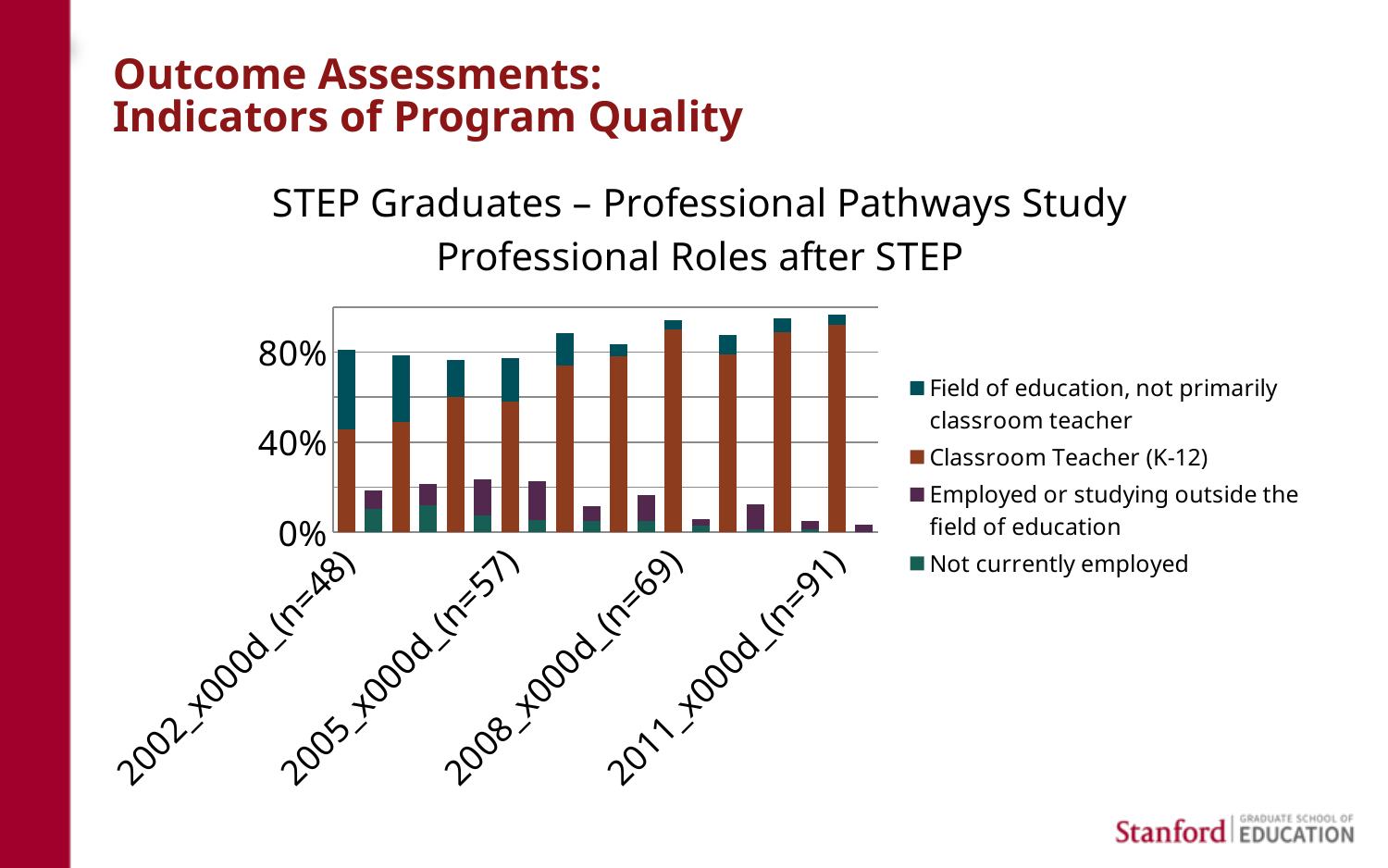
Which legend entry is shown in brown? Classroom Teacher (K-12) Is the Not currently employed value for 2011 (n=91) greater or less than 40%? less Is the Classroom Teacher (K-12) value for 2008 (n=69) greater or less than 40%? greater Which is larger, the Field of education, not primarily classroom teacher value for 2002 (n=48) or for 2011 (n=91)? 2002 (n=48) Does the Classroom Teacher (K-12) share generally rise or fall from 2002 to 2011? rise Which is larger, the Classroom Teacher (K-12) value for 2011 (n=91) or for 2002 (n=48)? 2011 (n=91) Among the labeled years, which has the highest Classroom Teacher (K-12) value? 2011 (n=91) Is the Classroom Teacher (K-12) value for 2002 (n=48) greater or less than 80%? less How many series does the chart legend list? 4 What kind of chart is shown on the slide? Stacked bar chart What is the title of the chart? STEP Graduates – Professional Pathways Study Professional Roles after STEP